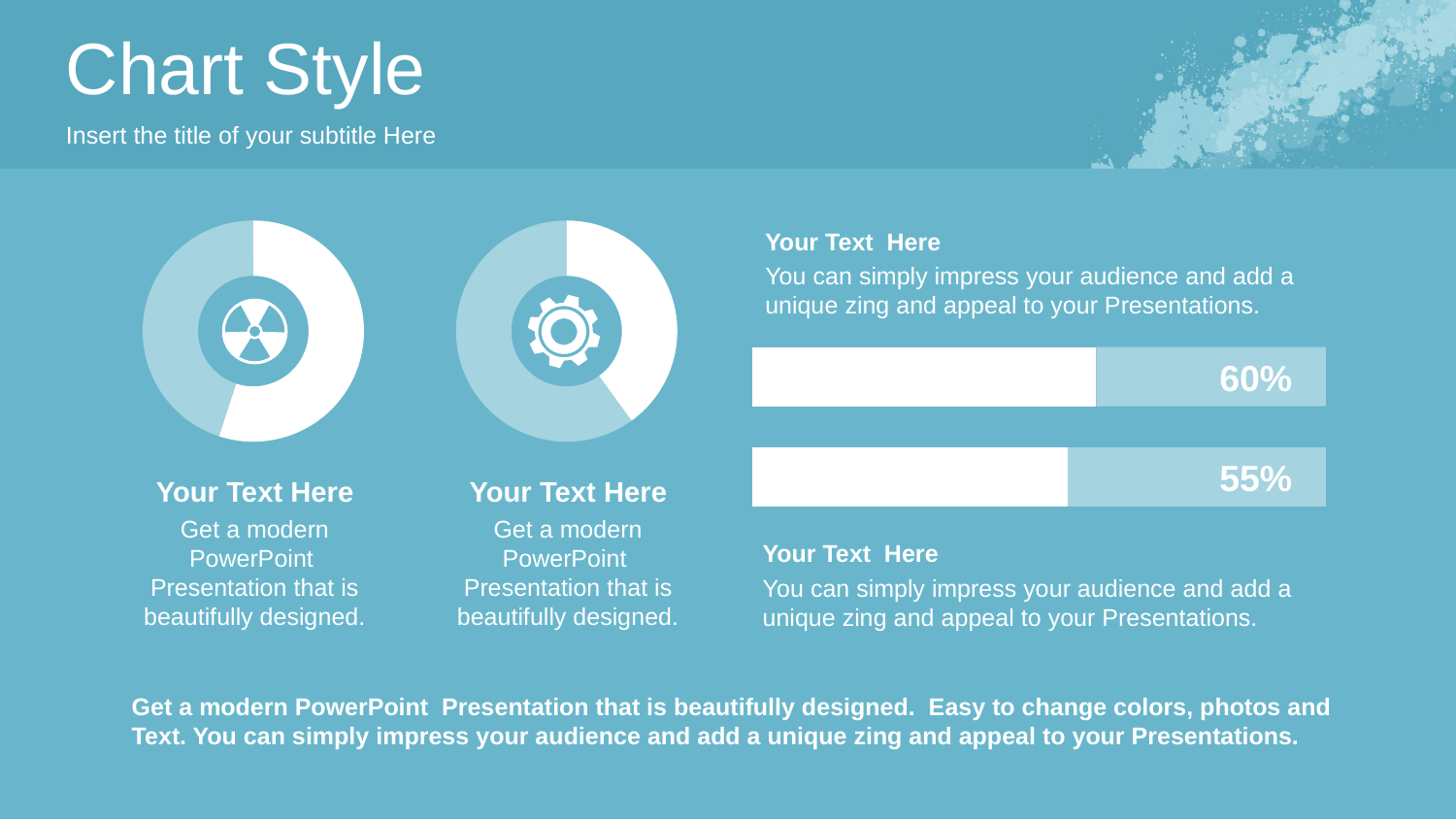
Is the value of the upper horizontal bar on the right larger or smaller than the value of the lower bar? larger What is the difference between the values of the upper and lower horizontal bars on the right side of the slide? 5% In the doughnut chart with the radiation icon, which slice is larger, the white one or the light blue one? The white one How many horizontal bars are shown on the right side of the slide? 2 Of the two horizontal bars on the right side of the slide, which has the higher value? The upper bar (60%) What kind of chart is shown on the left side of the slide with the radiation icon in the centre? Doughnut chart What value is labelled on the lower horizontal bar on the right side of the slide? 55% How many doughnut charts are shown on the slide? 2 How many slices does the doughnut chart with the radiation icon have? 2 Of the two horizontal bars on the right side of the slide, which has the lower value? The lower bar (55%) What value is labelled on the upper horizontal bar on the right side of the slide? 60% What is the title of the slide containing these charts? Chart Style